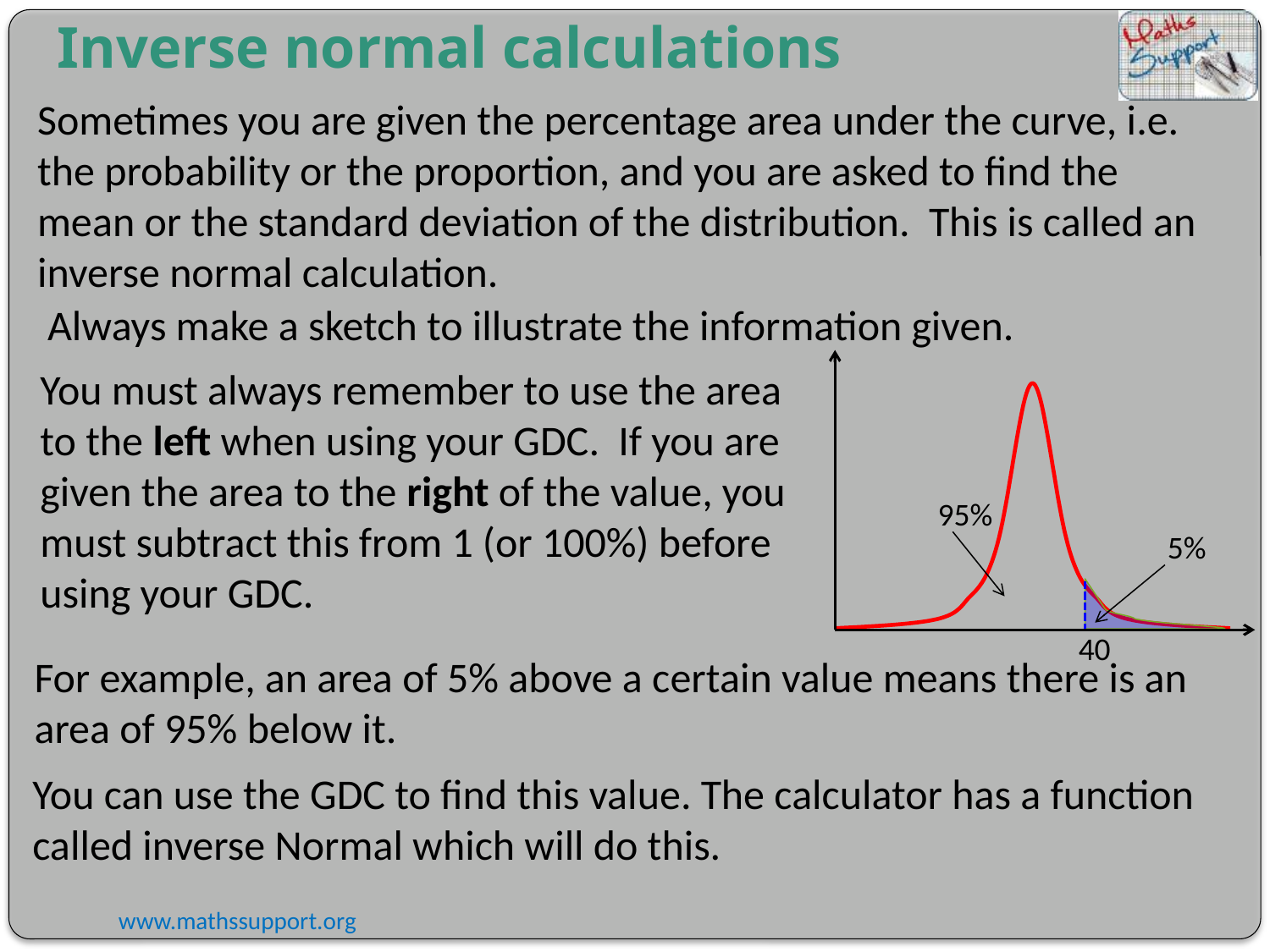
In the sketch on the right, what percentage of the area lies to the left of the dashed line? 95% In the sketch on the right, is the dashed vertical line at 40 to the left or the right of the curve's peak? Right In the sketch on the right, how many area percentages are labelled on the curve? 2 In the sketch on the right, what is the difference between the two labelled area percentages? 90% In the sketch on the right, what do the two labelled area percentages add up to? 100% In the sketch on the right, what colour is the distribution curve drawn in? Red In the sketch on the right, what value on the horizontal axis does the dashed line mark? 40 In the sketch on the right, which region has the larger area, the one labelled 95% or the one labelled 5%? 95% In the sketch on the right, what percentage of the area is shaded to the right of the dashed line? 5%